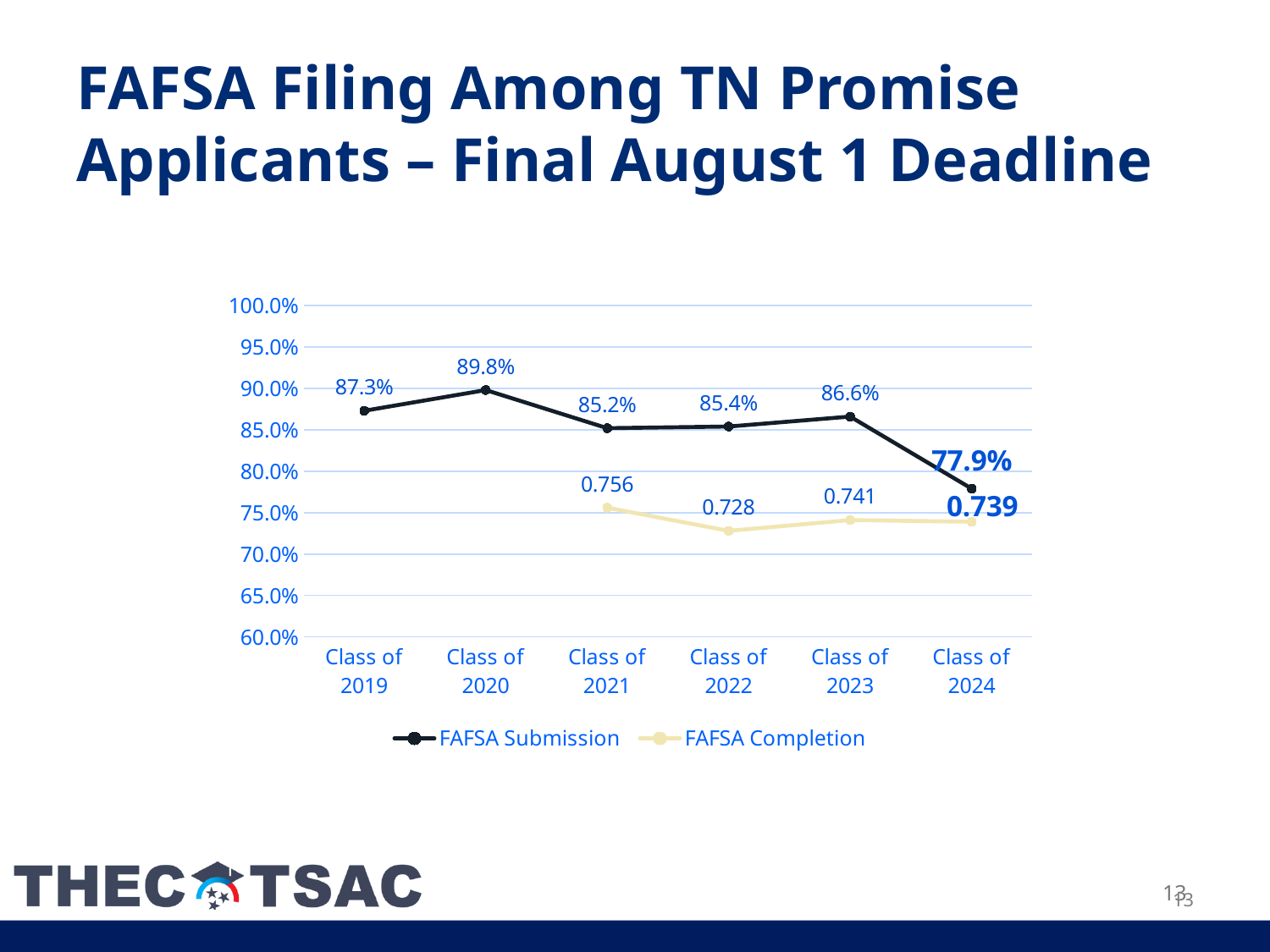
What kind of chart is shown on the slide? line chart What is the difference between the FAFSA Submission values for the Class of 2023 and the Class of 2024? 8.7% Is the FAFSA Submission value for the Class of 2019 greater or less than the value for the Class of 2021? greater What is the FAFSA Completion value for the Class of 2022? 0.728 How many classes are shown on the x axis? 6 Which class has the lowest FAFSA Completion value? Class of 2022 Is the FAFSA Submission value for the Class of 2024 greater or less than 80.0%? less What is the FAFSA Submission value for the Class of 2024? 77.9% Which class has the highest FAFSA Submission value? Class of 2020 What is the FAFSA Submission value for the Class of 2020? 89.8% Which class has the lowest FAFSA Submission value? Class of 2024 How many series does the legend list? 2